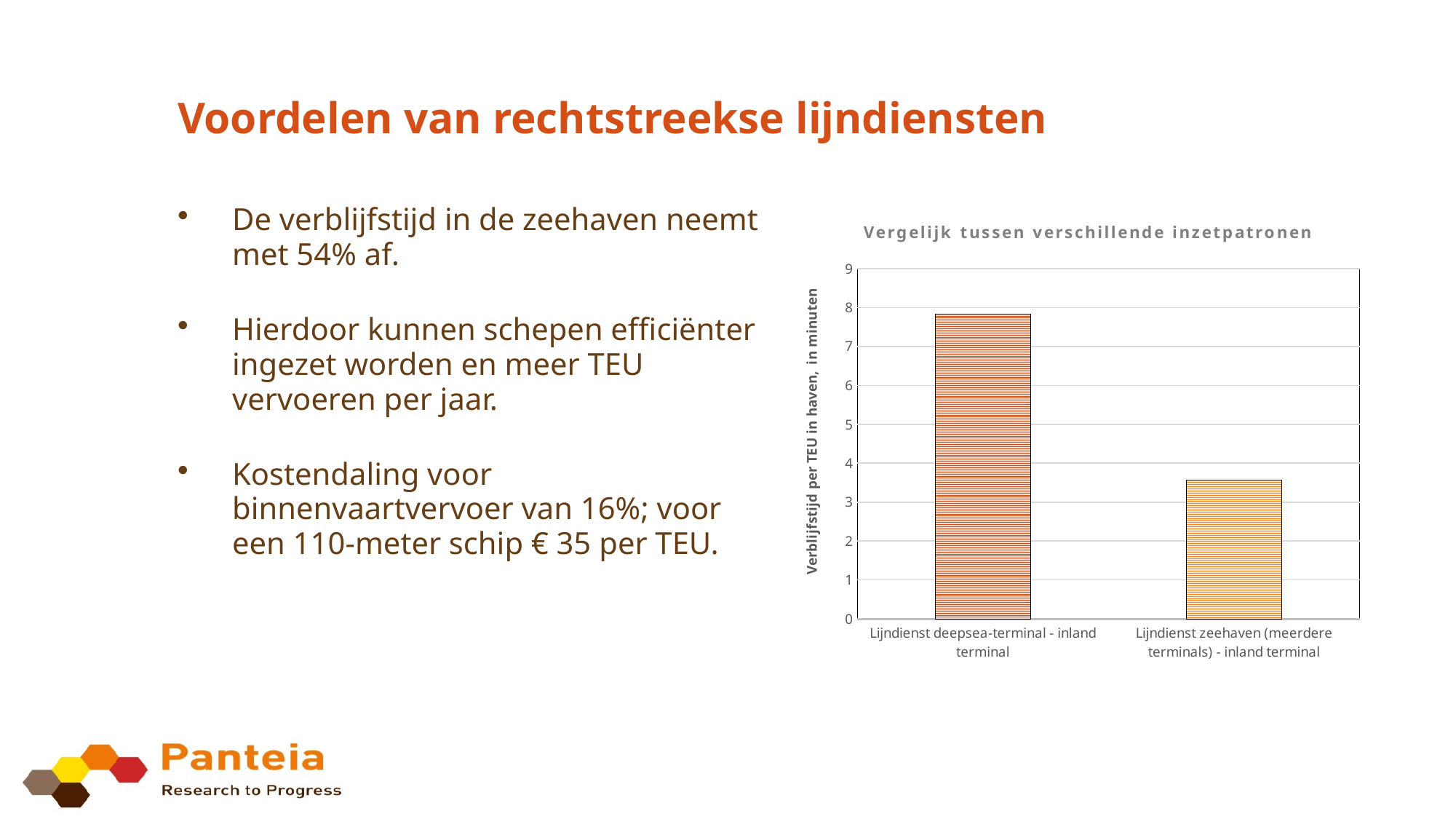
What is the label of the vertical axis of the chart? Verblijfstijd per TEU in haven, in minuten What kind of chart is shown on the slide? bar chart Is the value for 'Lijndienst zeehaven (meerdere terminals) - inland terminal' greater or less than 4? less Which category has the lowest value in the chart? Lijndienst zeehaven (meerdere terminals) - inland terminal Which category has the highest value in the chart? Lijndienst deepsea-terminal - inland terminal Is the value for 'Lijndienst zeehaven (meerdere terminals) - inland terminal' greater or less than 3? greater Which is larger: the value for 'Lijndienst deepsea-terminal - inland terminal' or for 'Lijndienst zeehaven (meerdere terminals) - inland terminal'? Lijndienst deepsea-terminal - inland terminal How many bars does the chart show? 2 Is the value for 'Lijndienst deepsea-terminal - inland terminal' greater or less than 8? less What is the title of the chart? Vergelijk tussen verschillende inzetpatronen